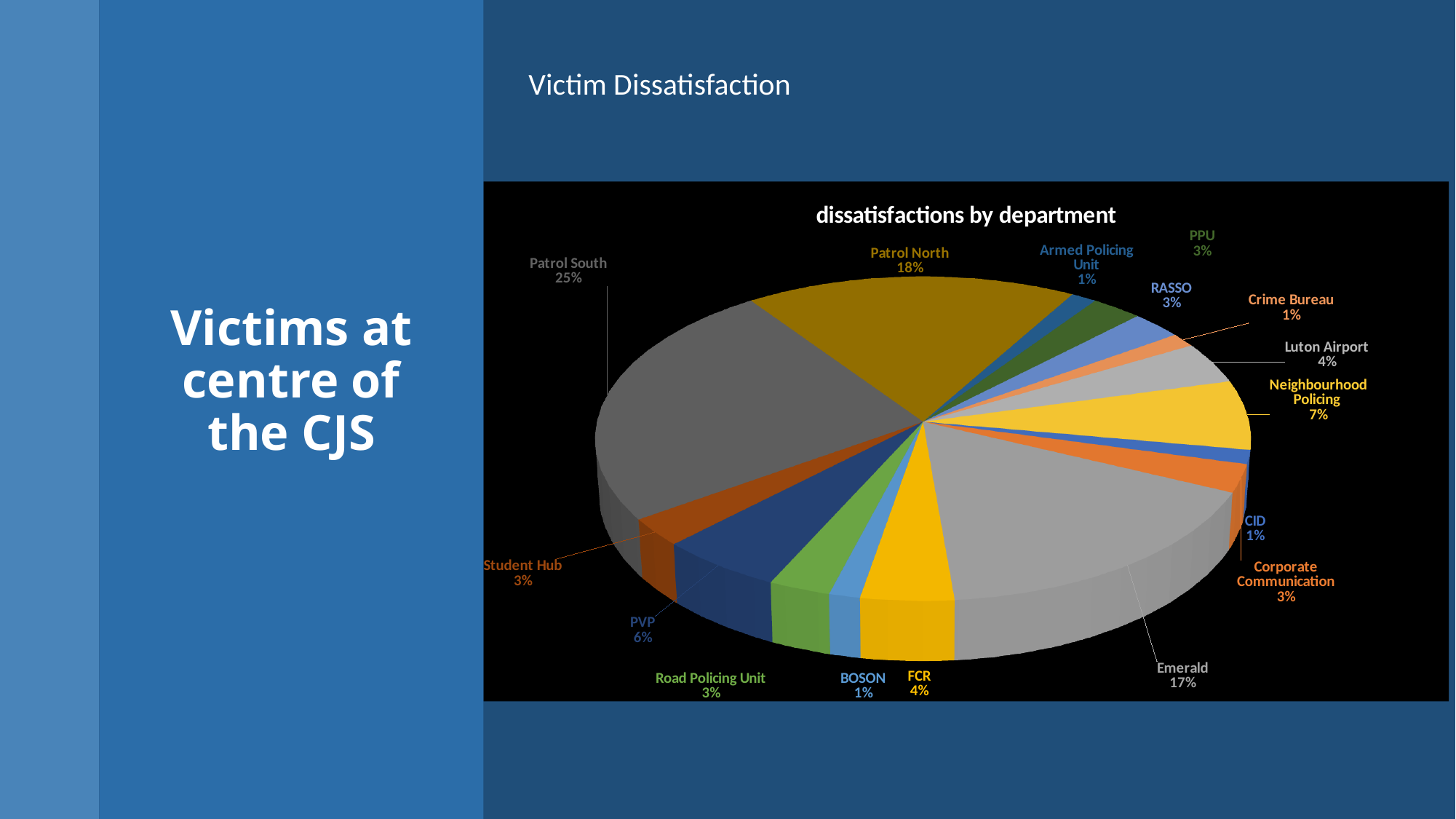
What is the title of the chart? dissatisfactions by department Which has a larger share of dissatisfactions, Emerald or Neighbourhood Policing? Emerald How many departments are shown in the pie chart? 16 What share of dissatisfactions is attributed to PVP? 6% What share of dissatisfactions is attributed to Luton Airport? 4% What is the combined share of Patrol South and Emerald? 42% What share of dissatisfactions is attributed to Neighbourhood Policing? 7% What is the difference in share between Patrol South and Patrol North? 7% Which department has the largest share of dissatisfactions? Patrol South What kind of chart is shown on the slide? pie chart